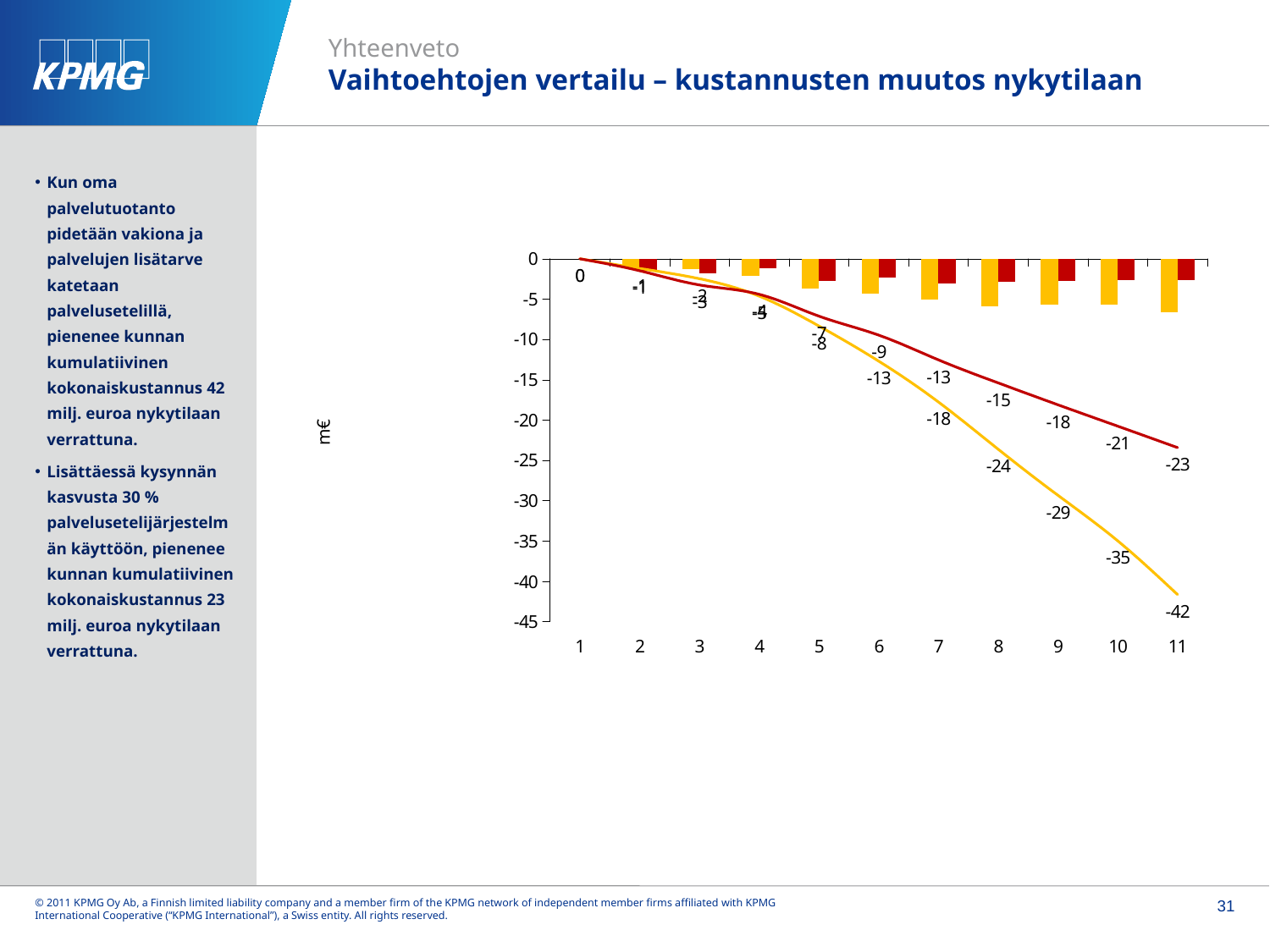
What is the difference between the red line (-23) and the yellow line (-42) at x = 11? 19 What is the value of the red line at x = 7? -13 What is the value of the yellow line at x = 11? -42 At which x value does the yellow line reach its lowest value? 11 What is the value of the yellow line at x = 10? -35 What is the value of the red line at x = 9? -18 How many x-axis categories are shown on the chart? 11 What unit is shown on the vertical axis label of the chart? m€ Do the line values rise or fall as x increases from 1 to 11? fall What is the value of the yellow line at x = 8? -24 What is the value of the red line at x = 11? -23 At x = 8, which line has the larger (less negative) value, the red line or the yellow line? the red line